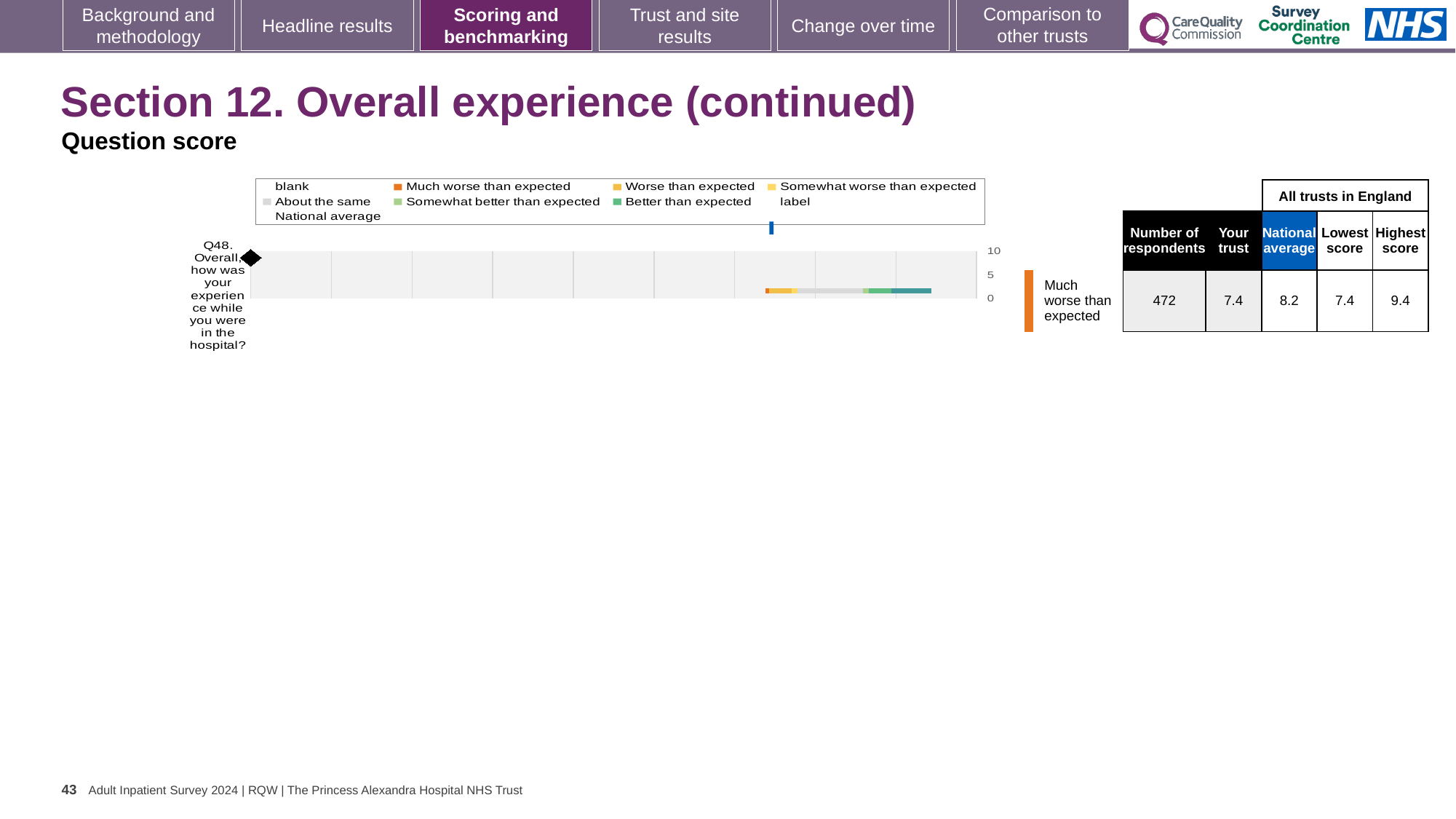
Which is larger for Q48: the 'Your trust' score or the national average score? National average What is the highest tick value shown on the chart's axis? 10 How many entries does the chart's legend list? 9 What kind of chart is shown on the slide? bar chart In the table beside the chart, what is the number of respondents for Q48? 472 In the table beside the chart, what is the national average score for Q48? 8.2 In the table beside the chart, what is the 'Your trust' score for Q48? 7.4 How many question categories are plotted on the chart? 1 In the table beside the chart, what is the highest score among all trusts in England for Q48? 9.4 Which question is plotted on the chart? Q48. Overall, how was your experience while you were in the hospital? In the table beside the chart, what is the lowest score among all trusts in England for Q48? 7.4 What is the difference between the national average score and the 'Your trust' score for Q48? 0.8